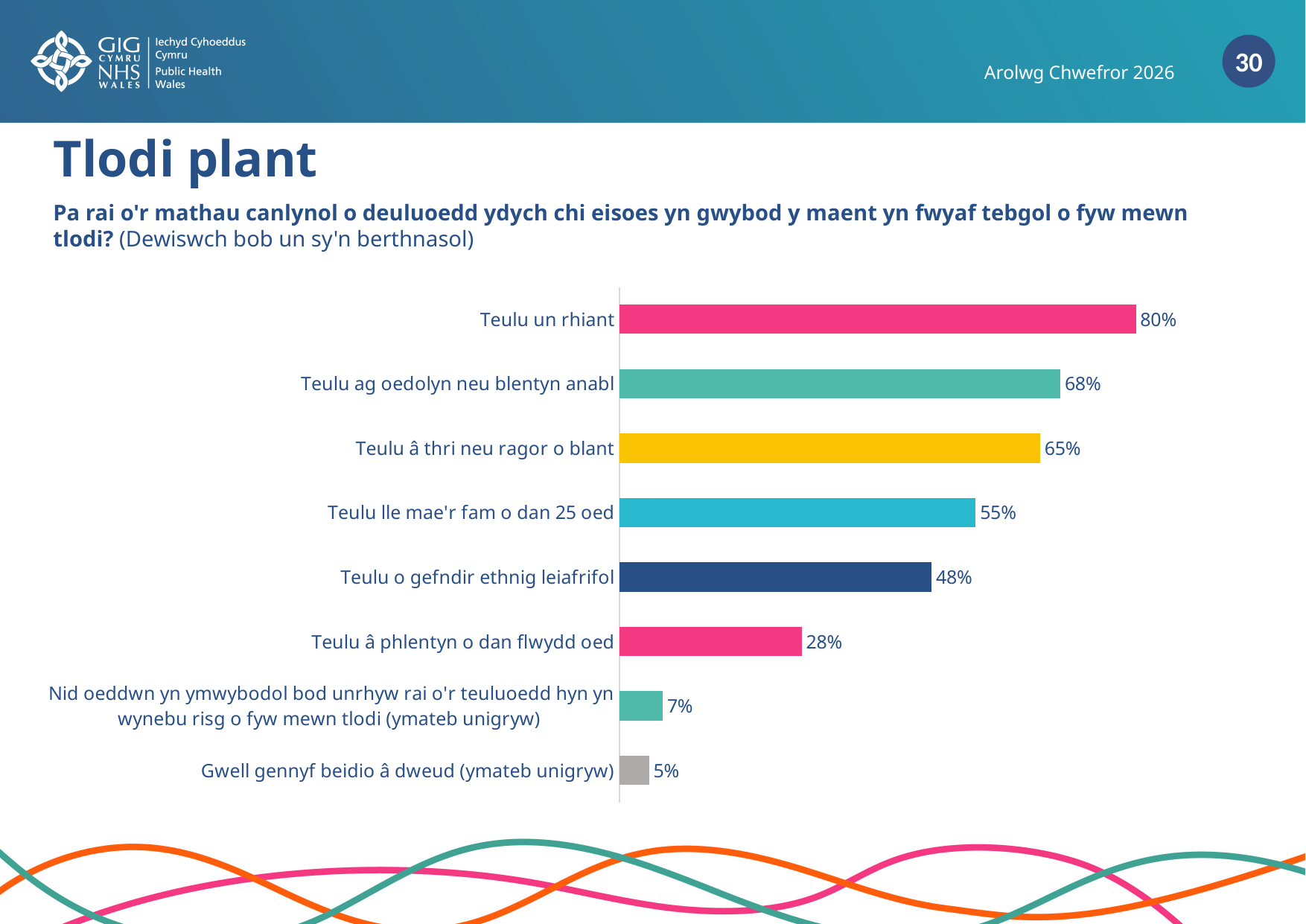
What kind of chart is shown on the slide? Bar chart What percentage is shown for 'Teulu â phlentyn o dan flwydd oed'? 28% Which category has the lowest value? Gwell gennyf beidio â dweud (ymateb unigryw) What is the title of the slide? Tlodi plant What is the difference between the values for 'Teulu â thri neu ragor o blant' and 'Teulu lle mae'r fam o dan 25 oed'? 10% What percentage is shown for 'Teulu lle mae'r fam o dan 25 oed'? 55% How many categories are shown in the chart? 8 Which is larger: the value for 'Teulu ag oedolyn neu blentyn anabl' or 'Teulu â thri neu ragor o blant'? Teulu ag oedolyn neu blentyn anabl What percentage is shown for 'Teulu un rhiant'? 80% What percentage is shown for 'Teulu ag oedolyn neu blentyn anabl'? 68% What is the difference between the values for 'Teulu un rhiant' and 'Teulu o gefndir ethnig leiafrifol'? 32% Which category has the highest value? Teulu un rhiant